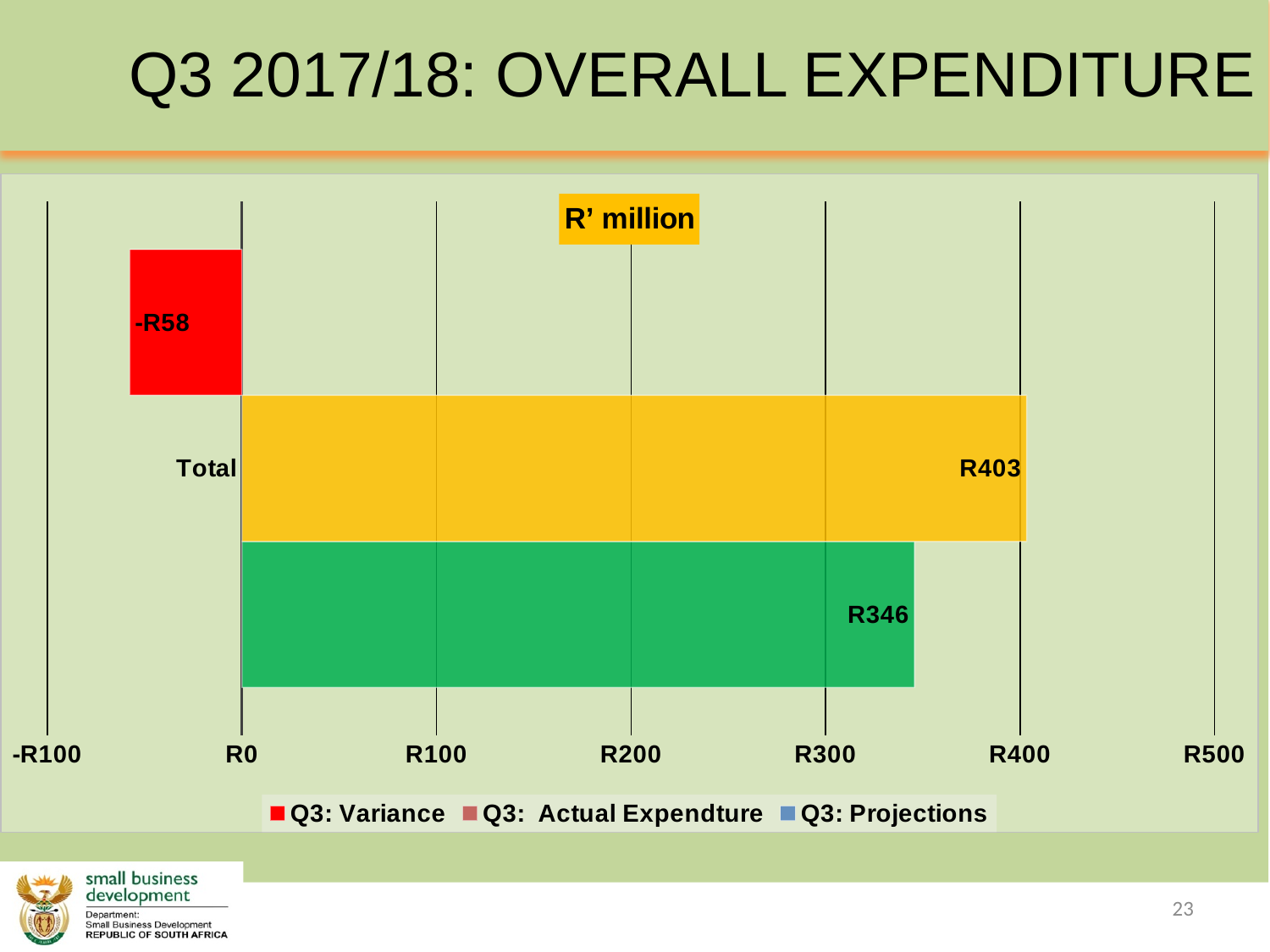
What is the difference between the yellow bar (R403) and the green bar (R346)? R57 Is the value of the green bar greater or less than R300? greater What is the value of the Q3: Variance bar (the red bar)? -R58 How many categories are shown on the category axis? 1 How many series does the legend list? 3 What unit label is shown at the top of the chart? R' million Which is larger, the yellow bar or the green bar? the yellow bar What value is labelled on the yellow bar? R403 What type of chart is shown on the slide? bar chart Which bar has the lowest value? the red Q3: Variance bar (-R58) Which bar has the highest value? the yellow bar (R403) What value is labelled on the green bar? R346